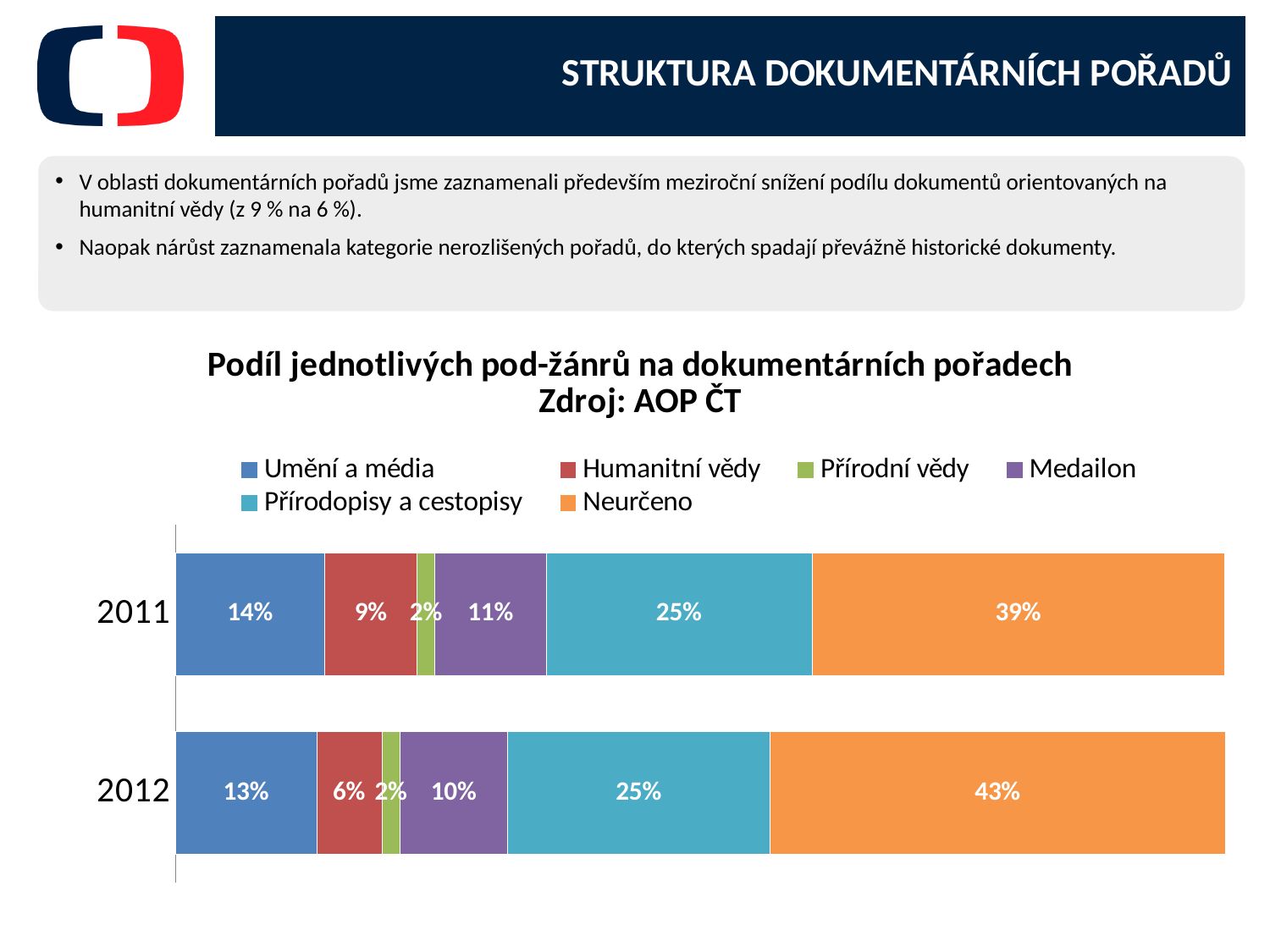
Is the share of Neurčeno larger in 2011 or in 2012? 2012 What is the value for Medailon in 2011? 11% How many series does the legend list? 6 What is the value for Neurčeno in 2012? 43% What is the value for Humanitní vědy in 2011? 9% What is the title of the chart? Podíl jednotlivých pod-žánrů na dokumentárních pořadech Zdroj: AOP ČT How many years (categories) are shown on the chart? 2 By how many percentage points did the share of Humanitní vědy change from 2011 to 2012? 3% What type of chart is shown on the slide? Stacked bar chart Which sub-genre has the largest share in 2012? Neurčeno What is the value for Umění a média in 2012? 13% Which sub-genre has the smallest share in 2011? Přírodní vědy